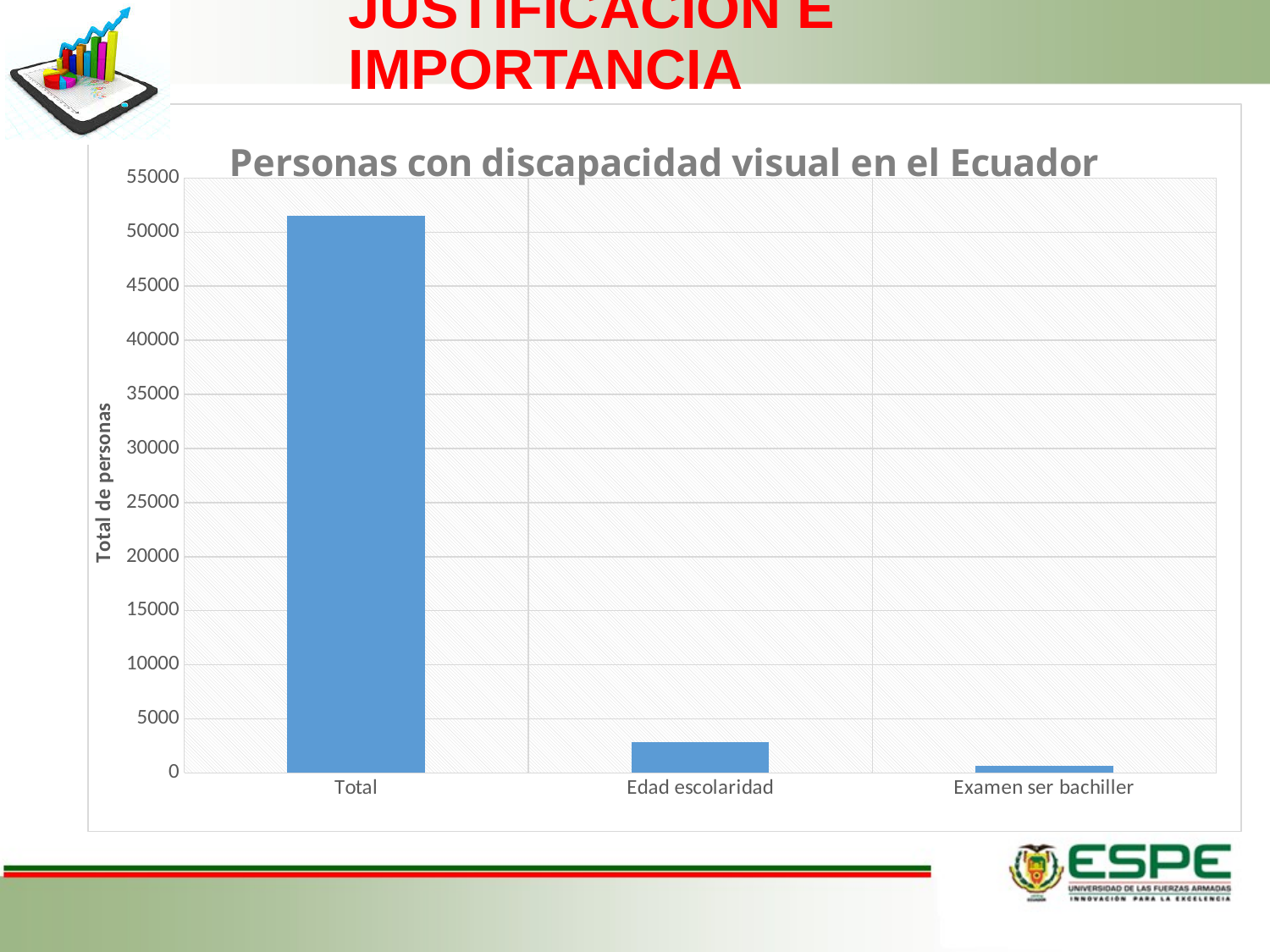
What is the title of the chart? Personas con discapacidad visual en el Ecuador What is the label of the vertical axis? Total de personas Do the values rise or fall moving from left to right along the x axis? fall Is the value for Examen ser bachiller greater or less than 5000? less Which category has the lowest value? Examen ser bachiller Which is larger, the value for Edad escolaridad or the value for Examen ser bachiller? Edad escolaridad How many categories are shown on the x axis? 3 Is the value for Total greater or less than 55000? less Which category has the highest value? Total Is the value for Edad escolaridad greater or less than 5000? less What kind of chart is shown on the slide? bar chart